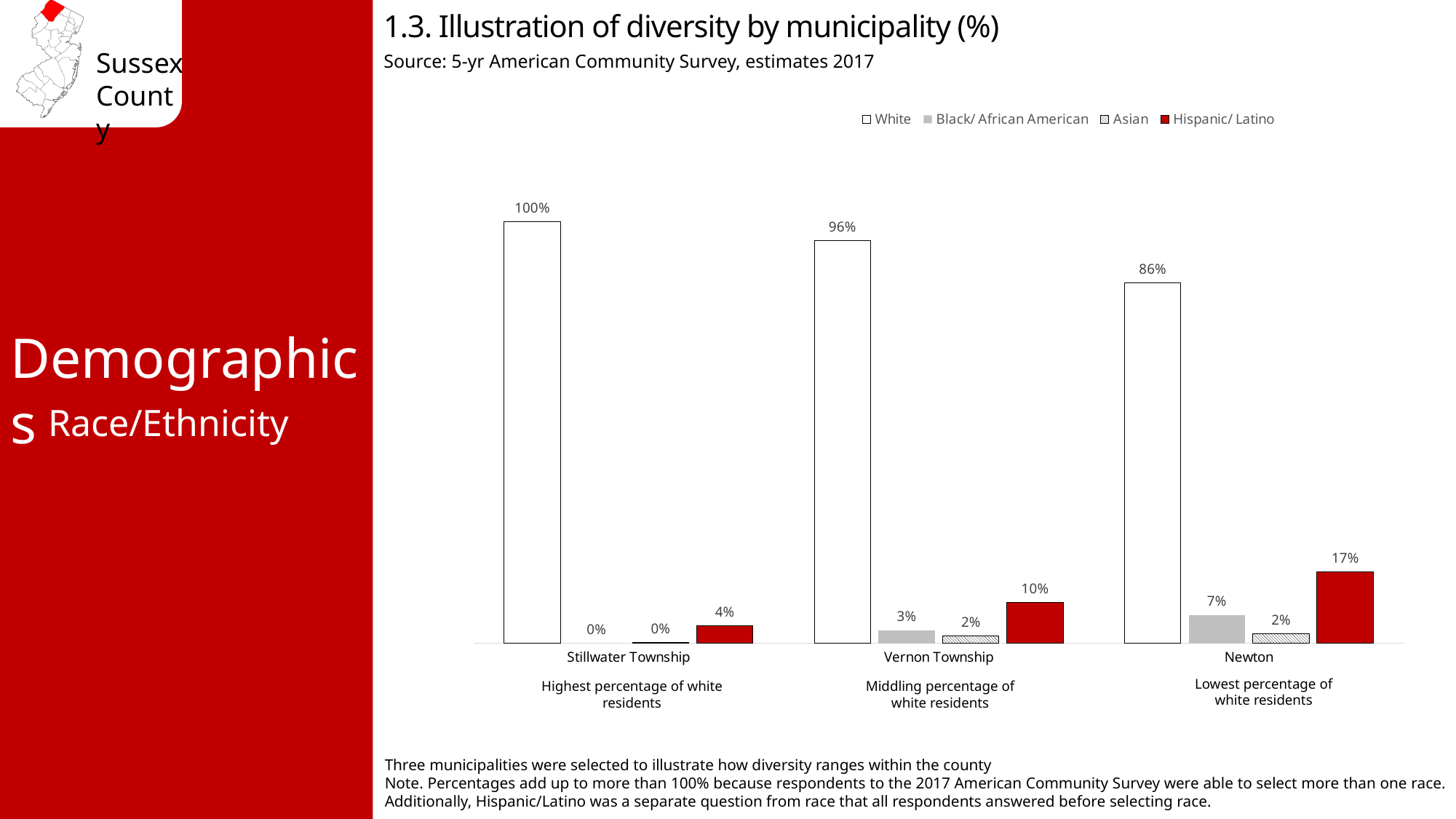
What is the Black/ African American percentage for Vernon Township? 3% How many series does the legend list? 4 What kind of chart is shown on the slide? Bar chart What is the difference between the White percentage for Stillwater Township and Newton? 14% Which municipality has the highest Hispanic/ Latino percentage? Newton What is the Hispanic/ Latino percentage for Newton? 17% Which is larger, the Hispanic/ Latino percentage for Vernon Township or for Newton? Newton Which municipality has the lowest White percentage? Newton How many municipalities are shown on the x axis? 3 What is the Asian percentage for Newton? 2% What is the White percentage for Stillwater Township? 100% Which series is shown in red? Hispanic/ Latino